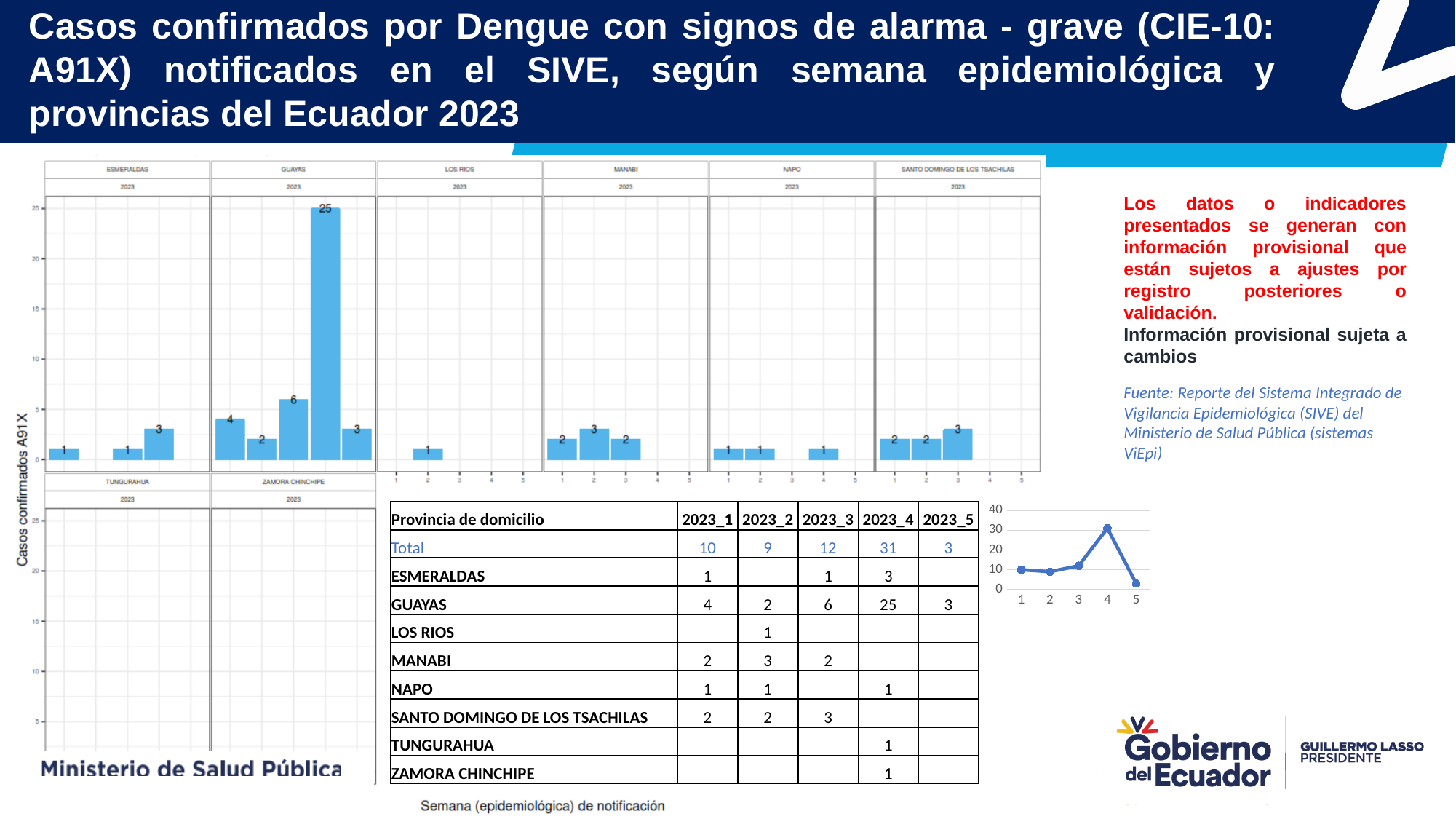
In the small line chart on the right, is the value for week 4 greater or less than 20? greater In the faceted bar chart, what is the value for GUAYAS in week 4? 25 What is the y-axis label of the faceted bar chart? Casos confirmados A91 X In the faceted bar chart, how many bars are shown in the LOS RIOS panel? 1 In the faceted bar chart, which is larger: the ESMERALDAS value for week 4 or the MANABI value for week 2? Neither; they are equal (both 3) In the faceted bar chart, what is the value for SANTO DOMINGO DE LOS TSACHILAS in week 3? 3 In the faceted bar chart, which week has the highest value for GUAYAS? 4 In the faceted bar chart, which week has the lowest value for GUAYAS? 2 What kind of chart is the faceted chart on the left of the slide? Bar chart In the small line chart on the right, is the value for week 5 greater or less than 10? less In the faceted bar chart, what is the difference between the GUAYAS values for week 4 and week 3? 19 In the faceted bar chart, what is the value for MANABI in week 2? 3